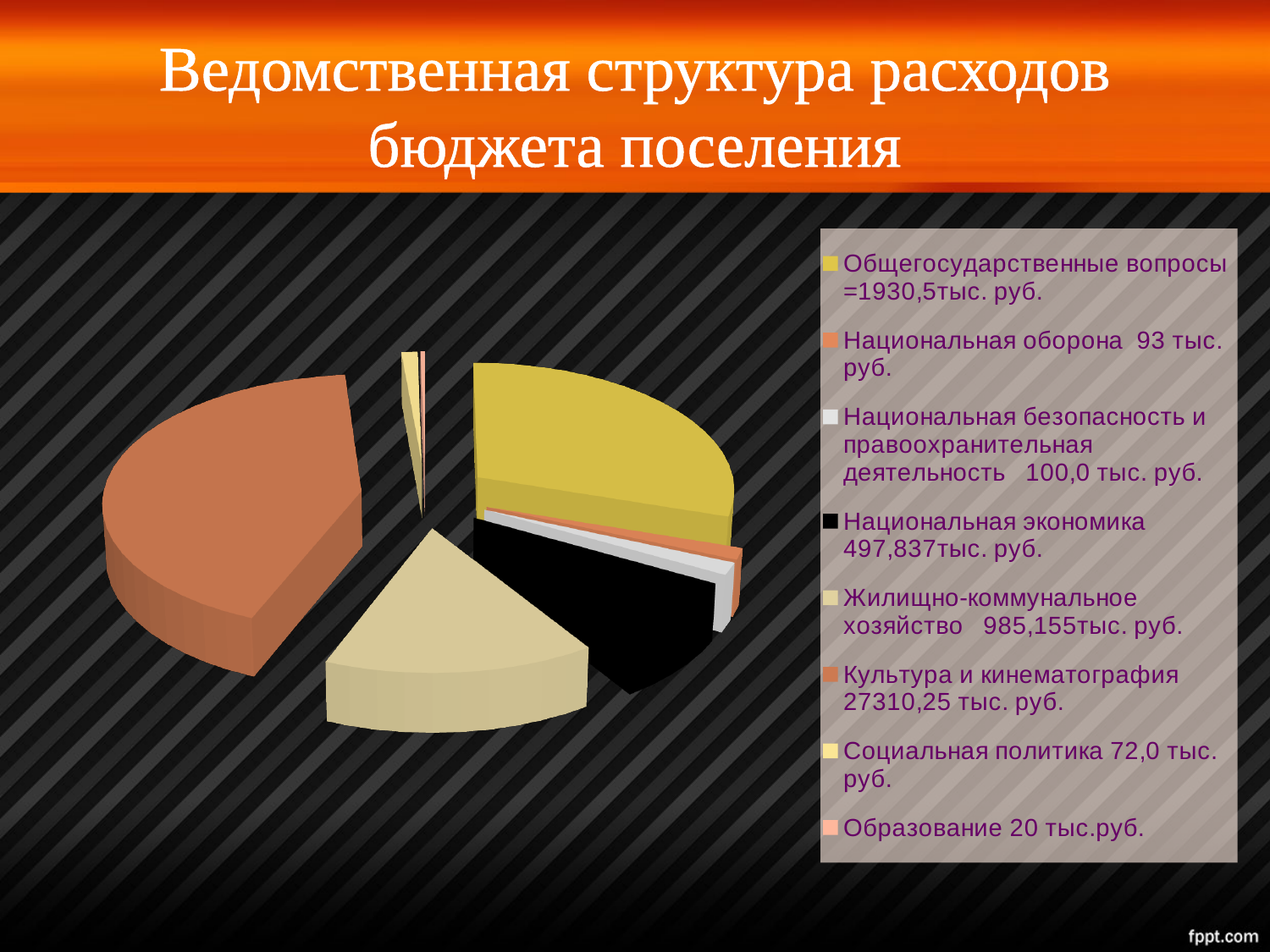
What is the difference between the values for Национальная безопасность и правоохранительная деятельность and Национальная оборона? 7 тыс. руб. What value is given for Образование? 20 тыс. руб. Which category has the smallest value? Образование Which is larger: Национальная оборона or Социальная политика? Национальная оборона What value is given for Культура и кинематография? 27310,25 тыс. руб. Which category has the largest value? Культура и кинематография What value is given for Общегосударственные вопросы? 1930,5 тыс. руб. What is the title of the slide's chart? Ведомственная структура расходов бюджета поселения What value is given for Национальная экономика? 497,837 тыс. руб. What value is given for Жилищно-коммунальное хозяйство? 985,155 тыс. руб. What type of chart is shown on the slide? Pie chart How many categories does the pie chart's legend list? 8